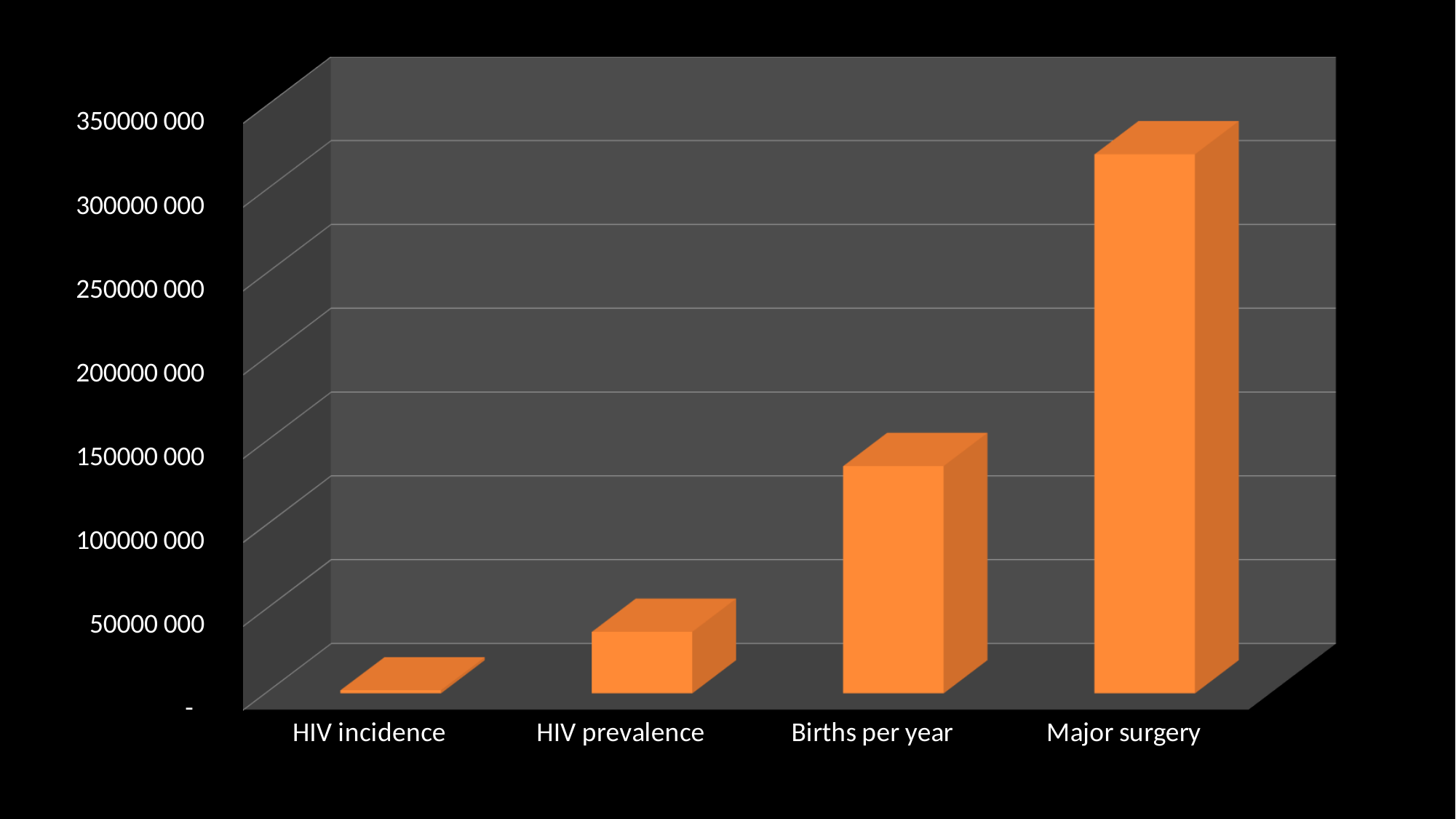
How many categories are plotted on the chart? 4 Is the value for HIV incidence greater or less than 50000 000? less Which is larger, the value for Births per year or the value for HIV prevalence? Births per year Do the values rise or fall moving from left to right along the x axis? rise Which is larger, the value for Major surgery or the value for Births per year? Major surgery Which category has the highest value? Major surgery Is the value for Major surgery greater or less than 300000 000? greater What kind of chart is shown on the slide? bar chart What colour are the bars on the chart? orange Which category has the lowest value? HIV incidence Is the value for Births per year greater or less than 100000 000? greater